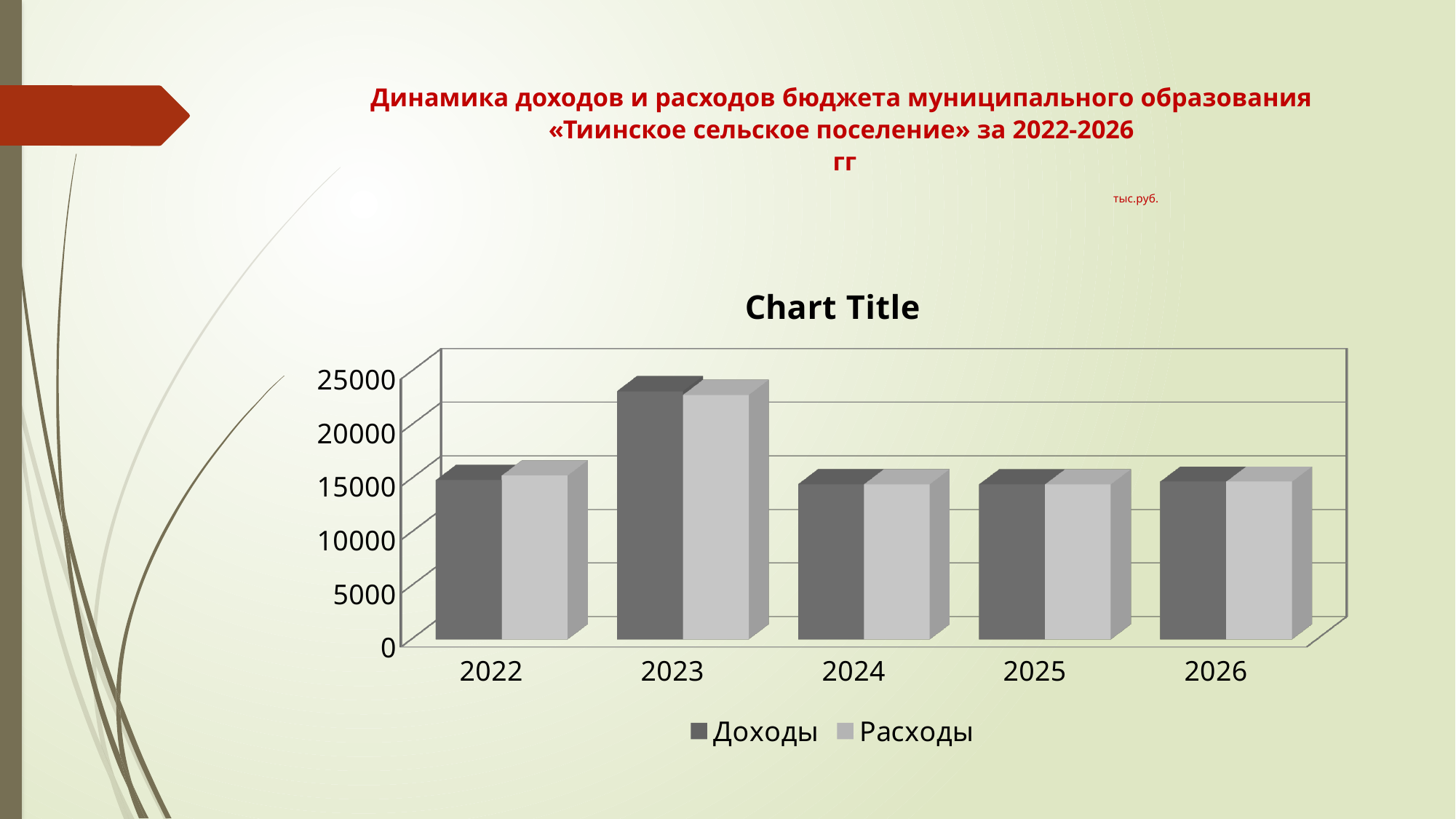
Do the values for Доходы rise or fall from 2023 to 2024? fall What kind of chart is shown on the slide? bar chart Is the value for Доходы in 2023 greater or less than 20000? greater Which year has the highest value for Расходы? 2023 Which is larger: Доходы in 2023 or Доходы in 2025? Доходы in 2023 Is the value for Расходы in 2023 greater or less than 20000? greater What are the two series named in the chart legend? Доходы and Расходы Which year has the highest value for Доходы? 2023 How many years are shown on the x axis of the chart? 5 Is the value for Доходы in 2024 greater or less than 20000? less How many series does the chart legend list? 2